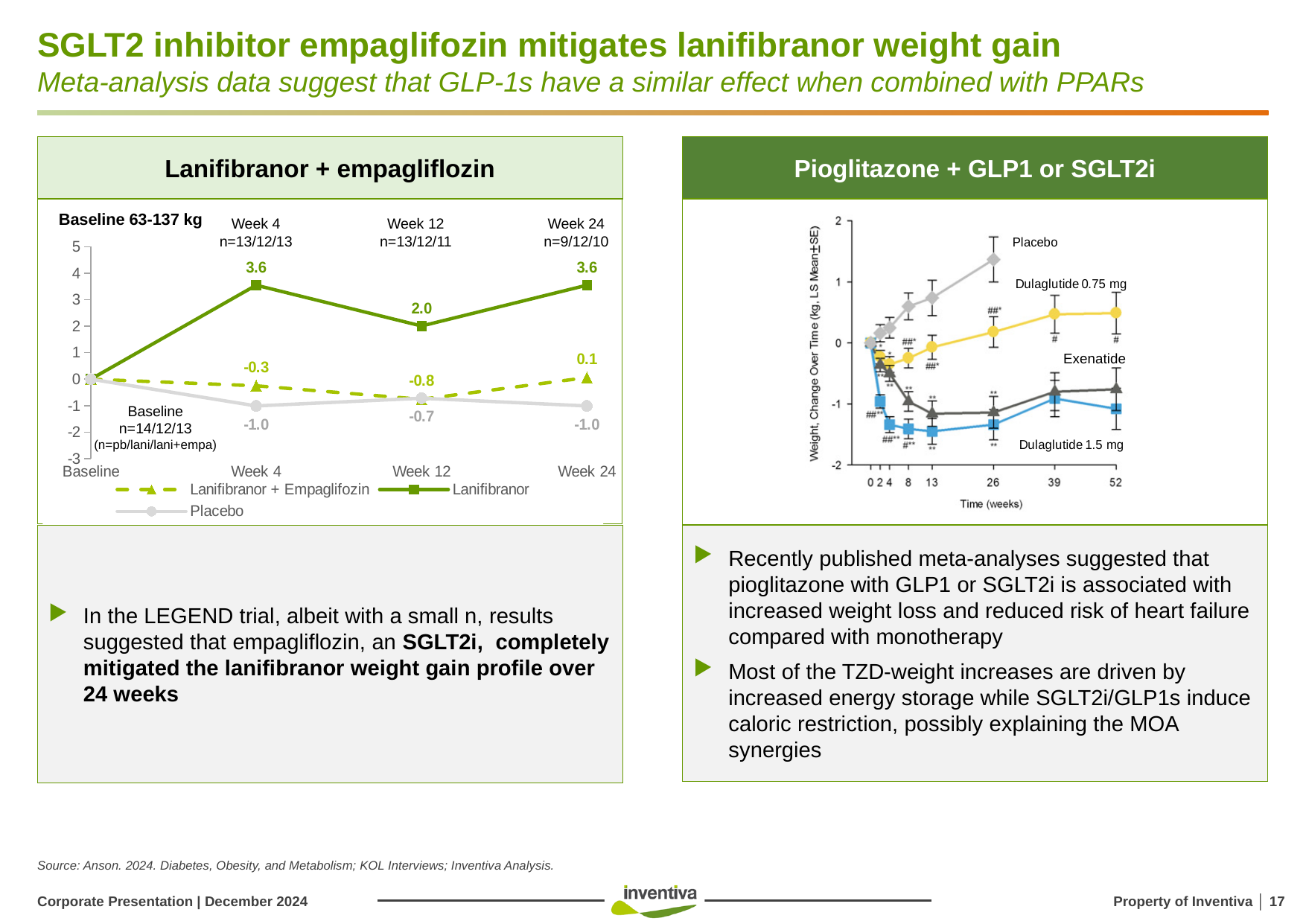
In the Lanifibranor + empagliflozin chart, what is the value for Placebo at Week 12? -0.7 How many series does the legend of the Lanifibranor + empagliflozin chart list? 3 What kind of chart is the Lanifibranor + empagliflozin chart? Line chart In the Pioglitazone + GLP1 or SGLT2i chart, is the Dulaglutide 1.5 mg value at week 13 greater or less than -1? less In the Lanifibranor + empagliflozin chart, which series has the lowest value at Week 4? Placebo In the Lanifibranor + empagliflozin chart, which is larger at Week 12: the Lanifibranor + Empagliflozin value or the Placebo value? Placebo In the Lanifibranor + empagliflozin chart, what is the value for Lanifibranor + Empagliflozin at Week 24? 0.1 How many time points are shown on the x axis of the Lanifibranor + empagliflozin chart? 4 In the Pioglitazone + GLP1 or SGLT2i chart, is the Placebo value at week 26 greater or less than 1? greater In the Lanifibranor + empagliflozin chart, what is the value for Lanifibranor at Week 12? 2.0 In the Lanifibranor + empagliflozin chart, which series has the highest value at Week 24? Lanifibranor In the Lanifibranor + empagliflozin chart, what is the difference between the Lanifibranor and Placebo values at Week 24? 4.6